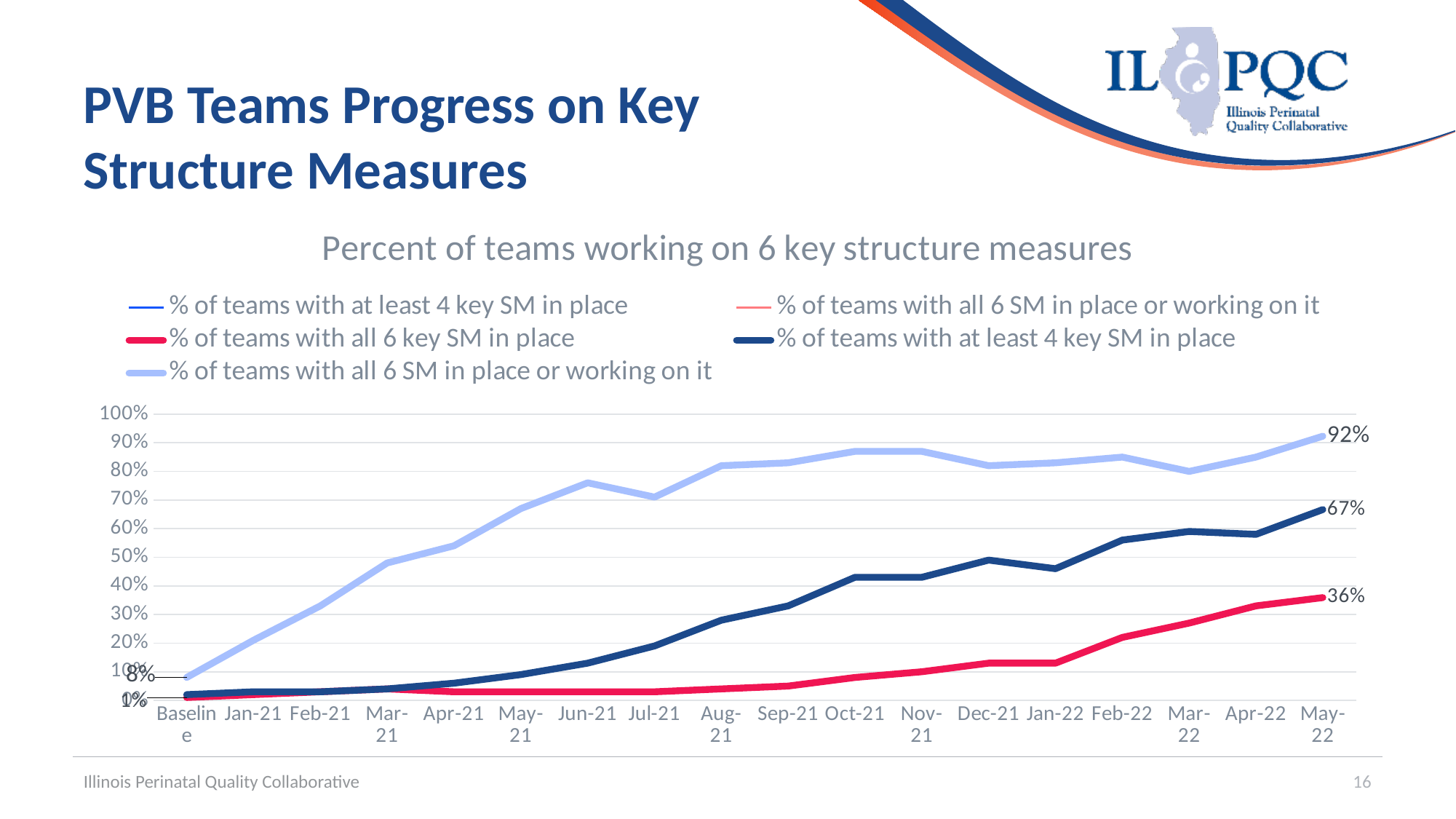
How many time points are shown on the x axis of the chart? 18 What is the value of the '% of teams with all 6 SM in place or working on it' line at May-22? 92% What is the value of the '% of teams with at least 4 key SM in place' line at May-22? 67% Does the '% of teams with all 6 key SM in place' line generally rise or fall from Baseline to May-22? Rise At May-22, what is the difference between the '% of teams with at least 4 key SM in place' value and the '% of teams with all 6 key SM in place' value? 31 percentage points Is the value of the '% of teams with at least 4 key SM in place' line at Jan-22 greater or less than 50%? less What is the value of the '% of teams with all 6 key SM in place' line at May-22? 36% What kind of chart is shown on the slide? Line chart Is the value of the '% of teams with all 6 key SM in place' line at Dec-21 greater or less than 20%? less At May-22, which is larger: '% of teams with at least 4 key SM in place' or '% of teams with all 6 key SM in place'? % of teams with at least 4 key SM in place At May-22, what is the difference between the '% of teams with all 6 SM in place or working on it' value and the '% of teams with at least 4 key SM in place' value? 25 percentage points Is the value of the '% of teams with all 6 SM in place or working on it' line at Oct-21 greater or less than 80%? greater